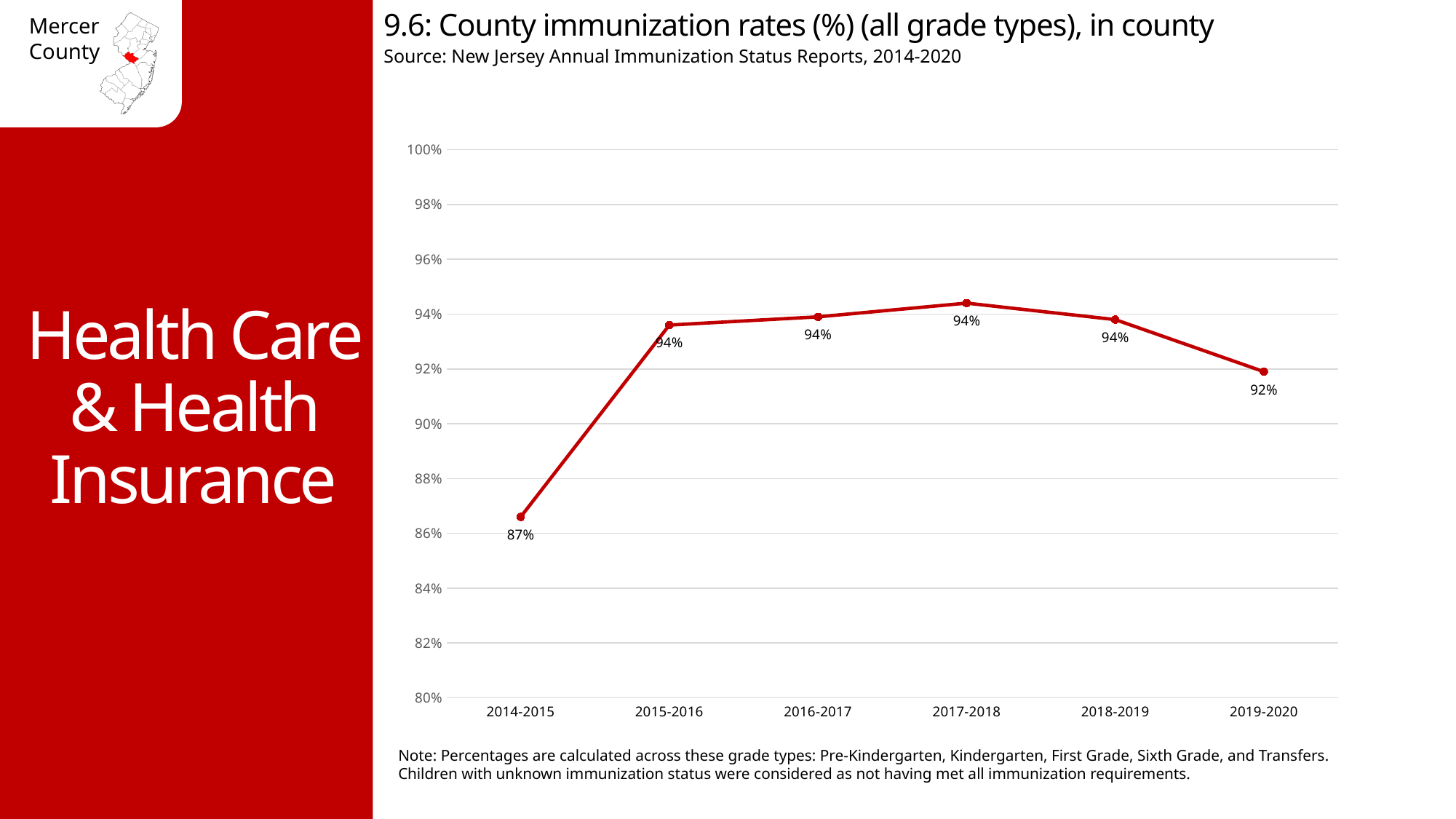
What is the county immunization rate for 2014-2015? 87% Is the immunization rate for 2014-2015 greater or less than 90%? less What is the county immunization rate for 2019-2020? 92% Does the immunization rate rise or fall from 2017-2018 to 2019-2020? fall Which is larger, the immunization rate for 2015-2016 or for 2019-2020? 2015-2016 Is the immunization rate for 2019-2020 greater or less than 90%? greater What kind of chart is shown on the slide? line chart What is the county immunization rate for 2017-2018? 94% What is the source cited for the chart data? New Jersey Annual Immunization Status Reports, 2014-2020 What is the difference in percentage points between the 2019-2020 rate and the 2014-2015 rate? 5 percentage points Which school year has the lowest immunization rate? 2014-2015 How many school years are plotted on the chart? 6